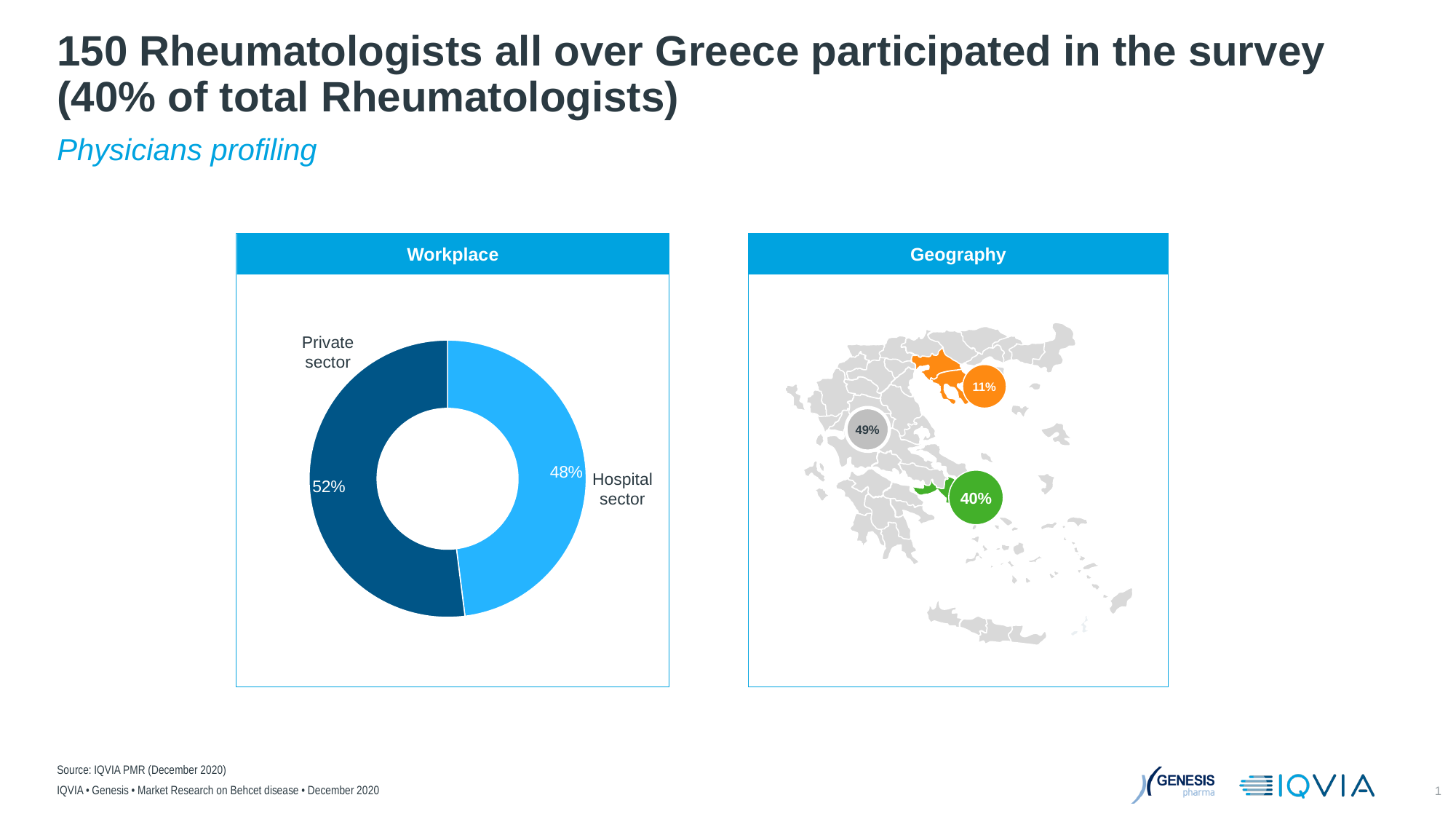
In the Workplace chart, which sector has the smaller share? Hospital sector In the Workplace chart, which colour represents the hospital sector? Light blue In the Workplace chart, what is the difference in percentage points between the private sector and the hospital sector? 4 In the Workplace chart, which sector has the larger share? Private sector In the Workplace chart, is the private sector share larger or smaller than the hospital sector share? larger On the Geography map, what percentage is shown in the green bubble? 40% What kind of chart is the Workplace chart? Donut (pie) chart On the Geography map, what percentage is shown in the orange bubble? 11% In the Workplace chart, what is the total of the two slices? 100% In the Workplace chart, what percentage of rheumatologists work in the private sector? 52% In the Workplace chart, what percentage of rheumatologists work in the hospital sector? 48% How many categories does the Workplace chart show? 2